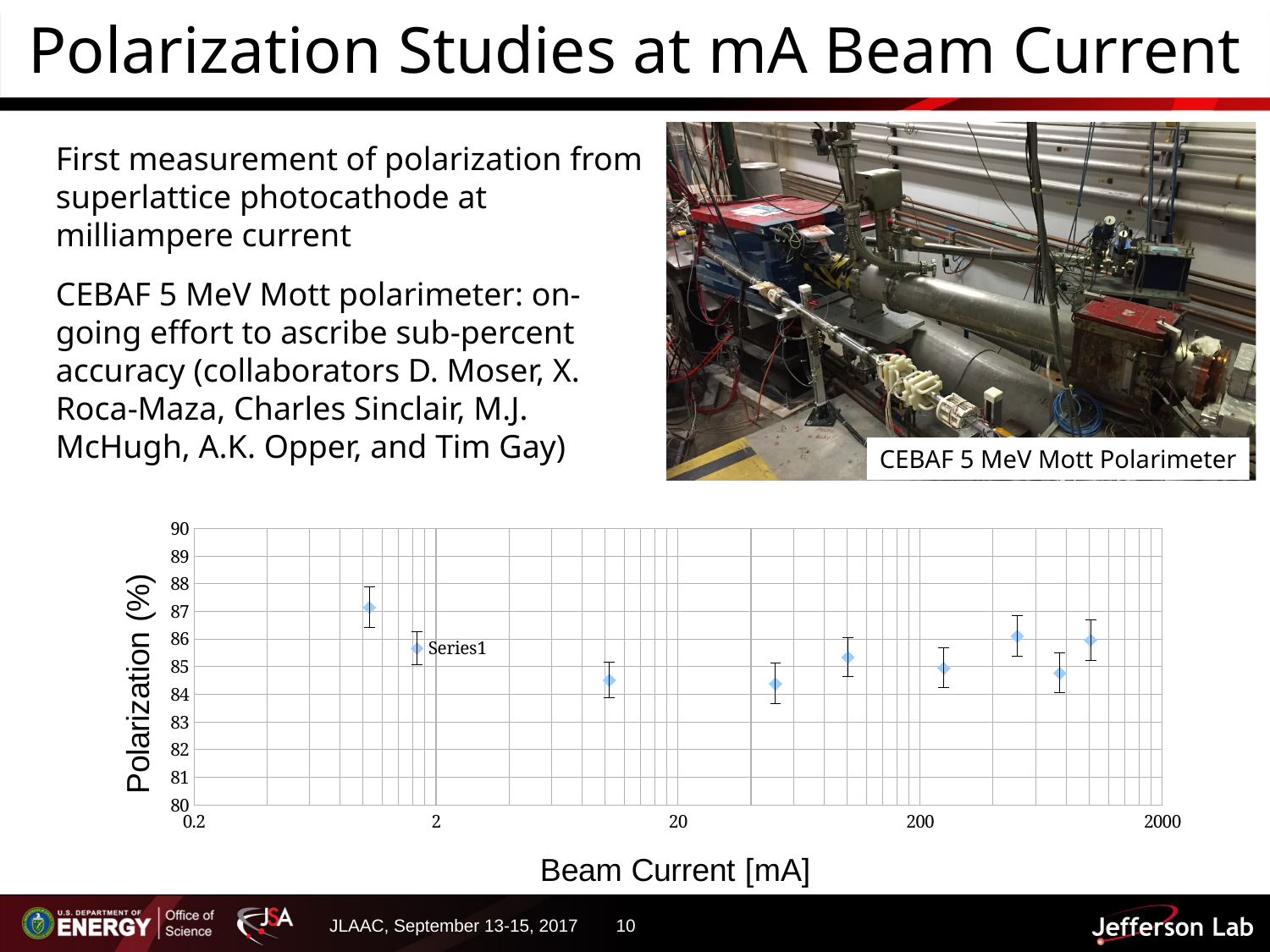
What is the label of the y axis of the chart? Polarization (%) Is the polarization value of the data point near 500 mA greater or less than 85? greater Which data point has the highest polarization value? the leftmost point (lowest beam current, near 1 mA) What is the label of the x axis of the chart? Beam Current [mA] Which is larger, the polarization of the leftmost data point or the polarization of the rightmost data point? the leftmost data point What kind of chart is shown on the slide? scatter plot How many data points are plotted in the chart? 9 How many series does the chart show? 1 Is the polarization value of the leftmost data point greater or less than 86? greater Is the polarization value of the data point just below 20 mA greater or less than 85? less What is the highest value shown on the y axis of the chart? 90